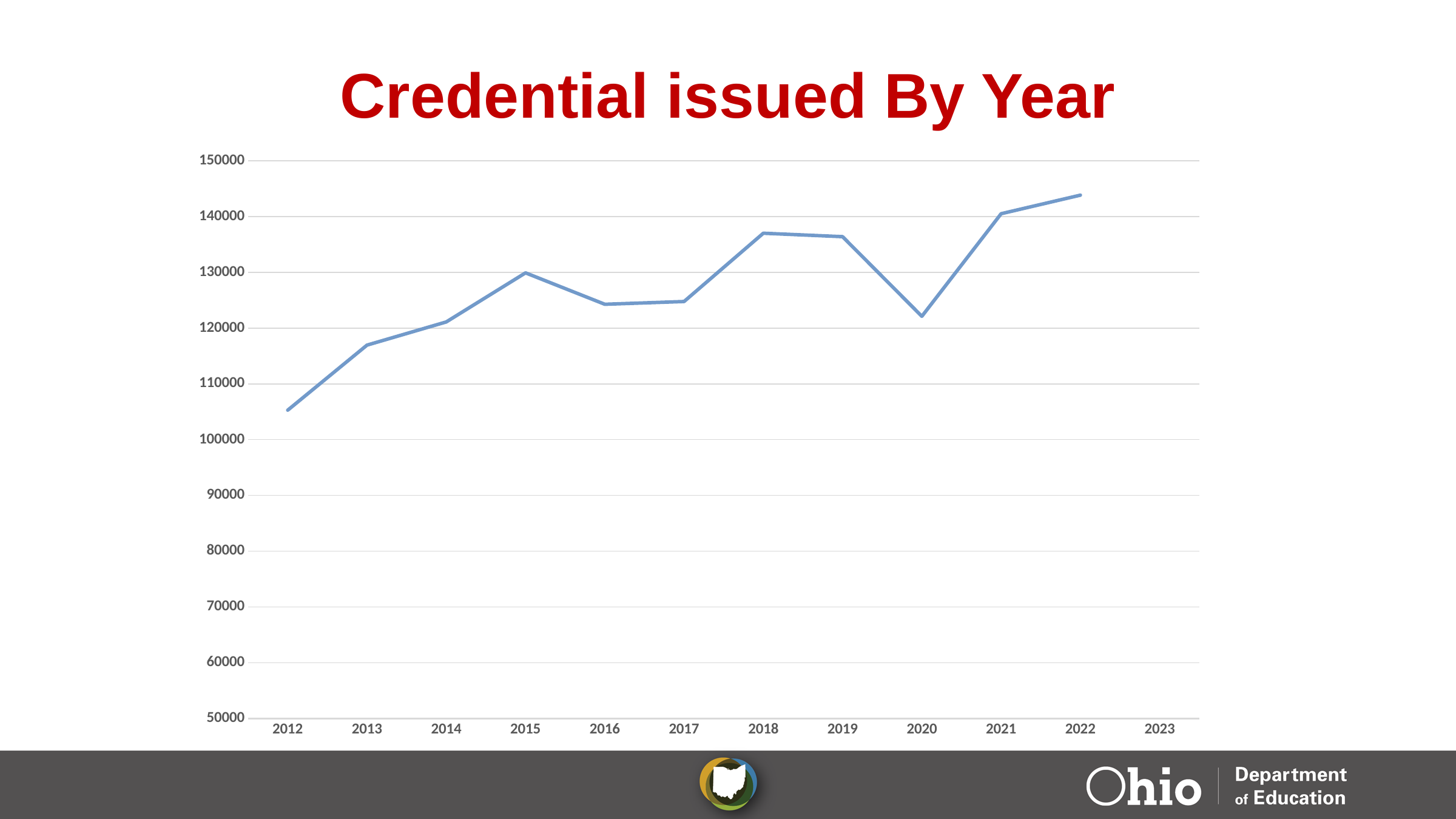
What is the title of the chart? Credential issued By Year Which year has a higher value, 2013 or 2014? 2014 Which year has a higher value, 2015 or 2020? 2015 Is the value for 2022 greater or less than 140000? greater Does the line rise or fall from 2019 to 2020? fall Which year has the highest number of credentials issued? 2022 What kind of chart is shown on the slide? line chart Is the value for 2020 greater or less than 120000? greater Is the value for 2012 greater or less than 110000? less How many years are labelled on the x axis? 12 Which year has the lowest number of credentials issued? 2012